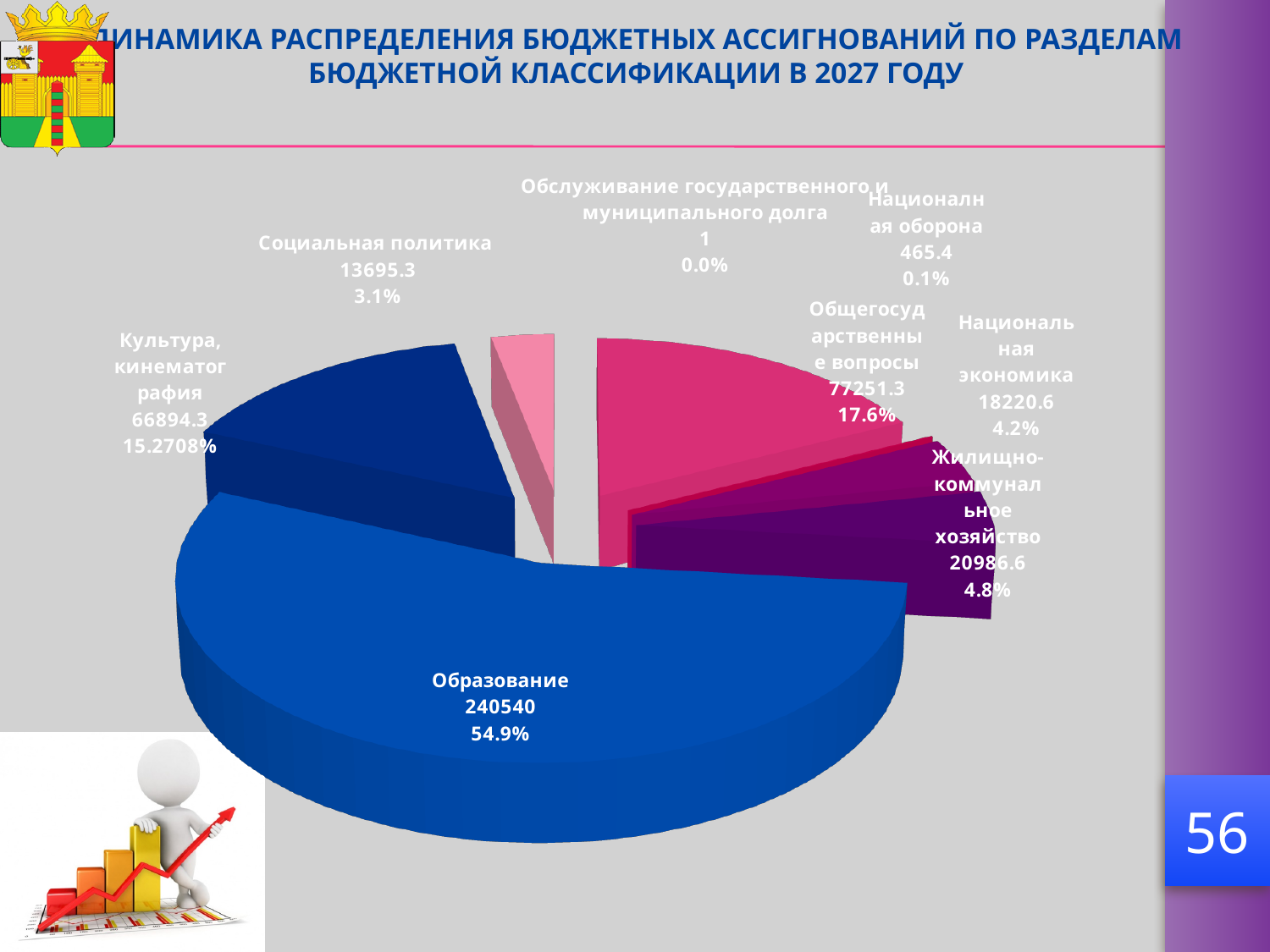
What percentage is shown for Национальная экономика? 4.2% What is the value shown for Образование? 240540 How many categories (slices) does the pie chart show? 8 Which category has the smallest value in the pie chart? Обслуживание государственного и муниципального долга What percentage is shown for Культура, кинематография? 15.2708% Which is larger: the value for Социальная политика or the value for Национальная оборона? Социальная политика What share of the pie does Образование represent? 54.9% Which category has the largest share of the pie? Образование What is the value shown for Жилищно-коммунальное хозяйство? 20986.6 What is the value shown for Общегосударственные вопросы? 77251.3 What is the difference between the values for Жилищно-коммунальное хозяйство and Национальная экономика? 2766 What kind of chart is shown on the slide? Pie chart